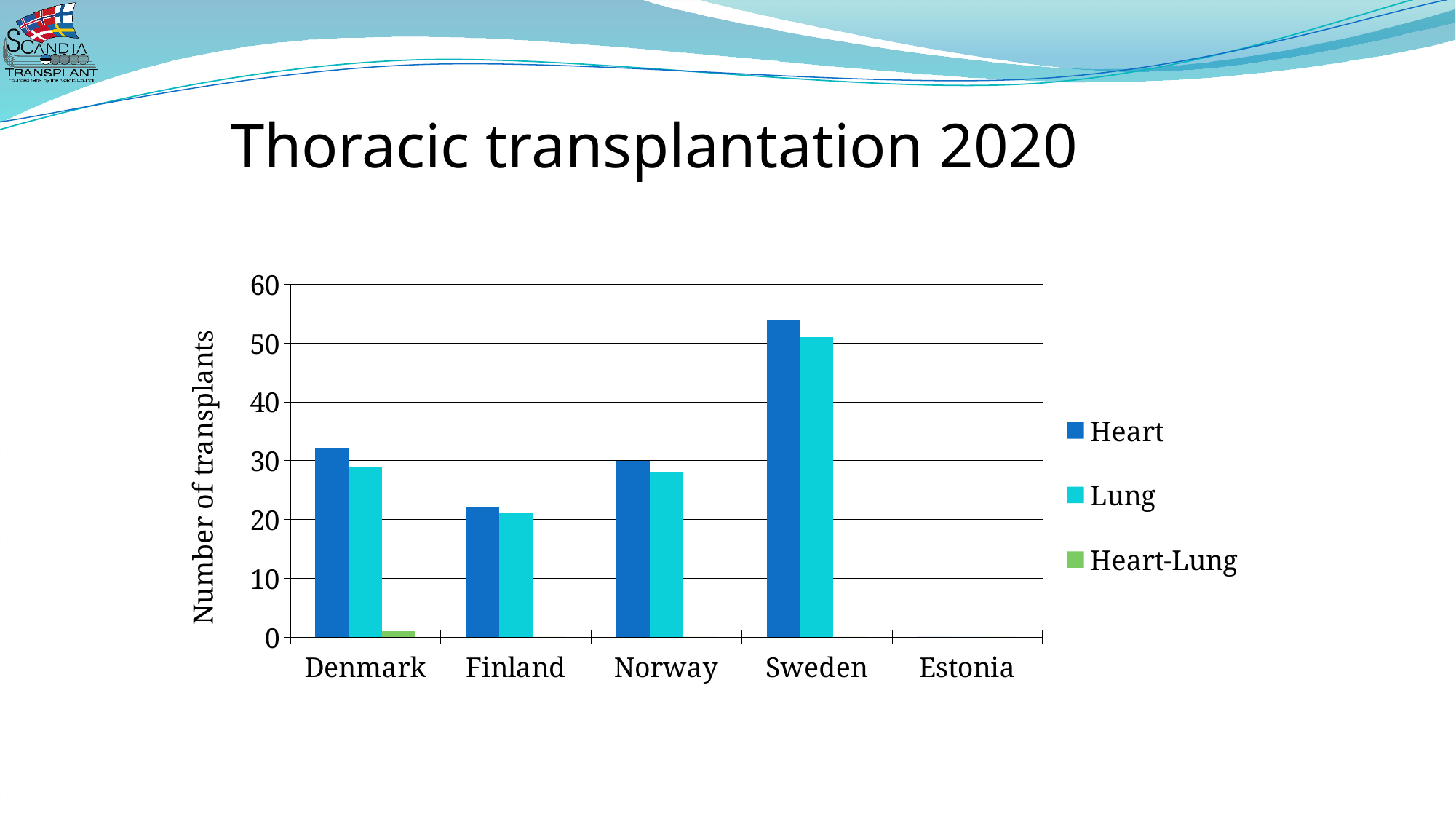
Which is larger, the Lung value for Sweden or the Lung value for Norway? Sweden Is the value for Sweden Heart greater or less than 50? greater How many series does the legend list? 3 How many countries are shown on the x axis? 5 What is the label of the y axis? Number of transplants Which is larger, the Heart value for Denmark or the Heart value for Finland? Denmark Is the value for Finland Lung greater or less than 30? less Among the countries with visible bars, which has the lowest number of heart transplants? Finland Which country has the highest number of lung transplants? Sweden Which country has the highest number of heart transplants? Sweden What kind of chart is shown on the slide? bar chart Is the value for Denmark Heart greater or less than 30? greater